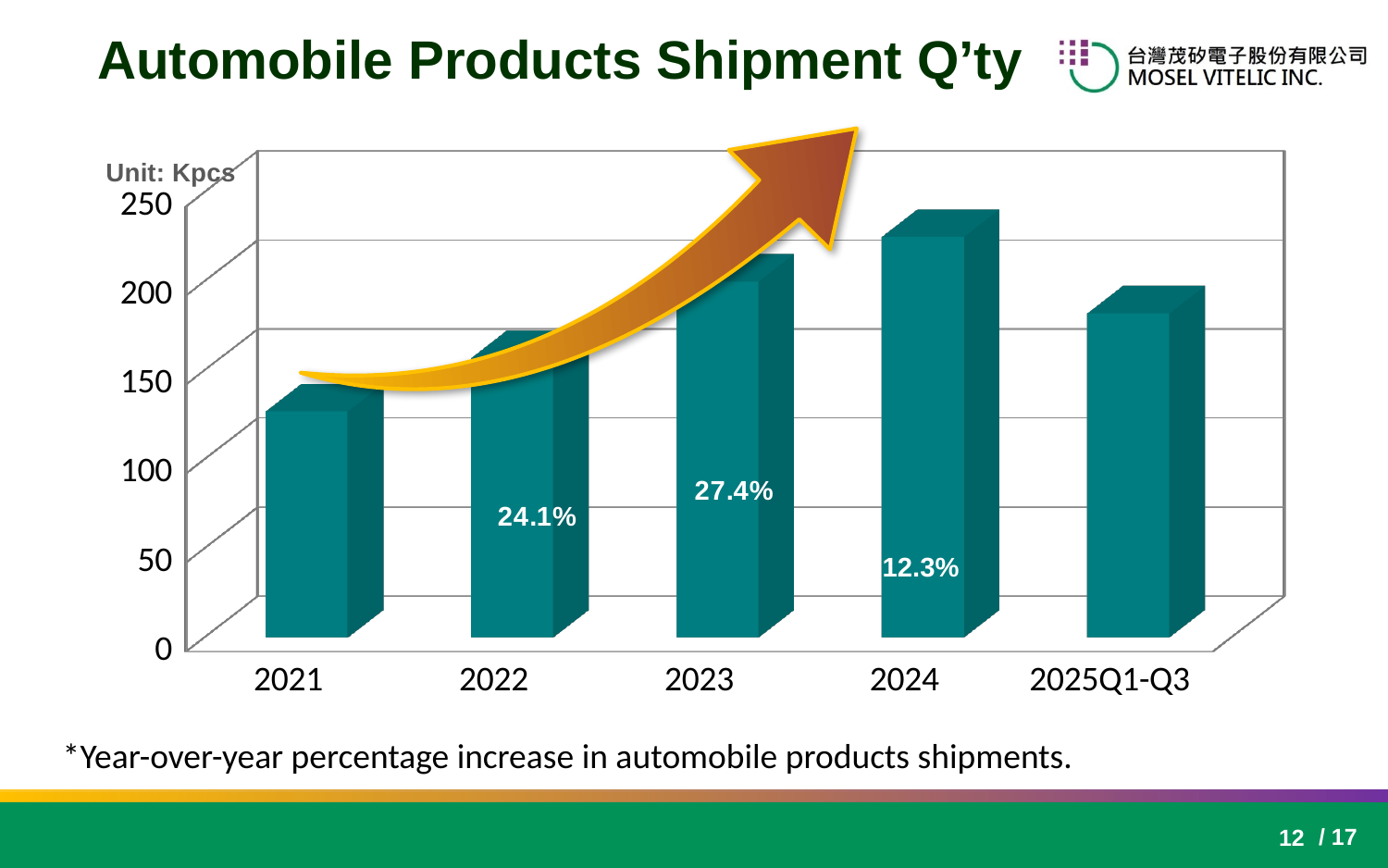
Which is larger, the shipment quantity for 2023 or for 2025Q1-Q3? 2023 What is the difference between the percentage labels for 2023 and 2024? 15.1 percentage points What year-over-year percentage increase is labelled on the 2024 bar? 12.3% Which year has the highest shipment quantity? 2024 What kind of chart is shown on the slide? bar chart What year-over-year percentage increase is labelled on the 2022 bar? 24.1% What unit is the shipment quantity measured in? Kpcs Is the shipment quantity for 2021 greater or less than 150? less Which category has the lowest shipment quantity? 2021 Which year shows the largest year-over-year percentage increase label? 2023 How many categories are shown on the x axis? 5 Is the shipment quantity for 2024 greater or less than 200? greater